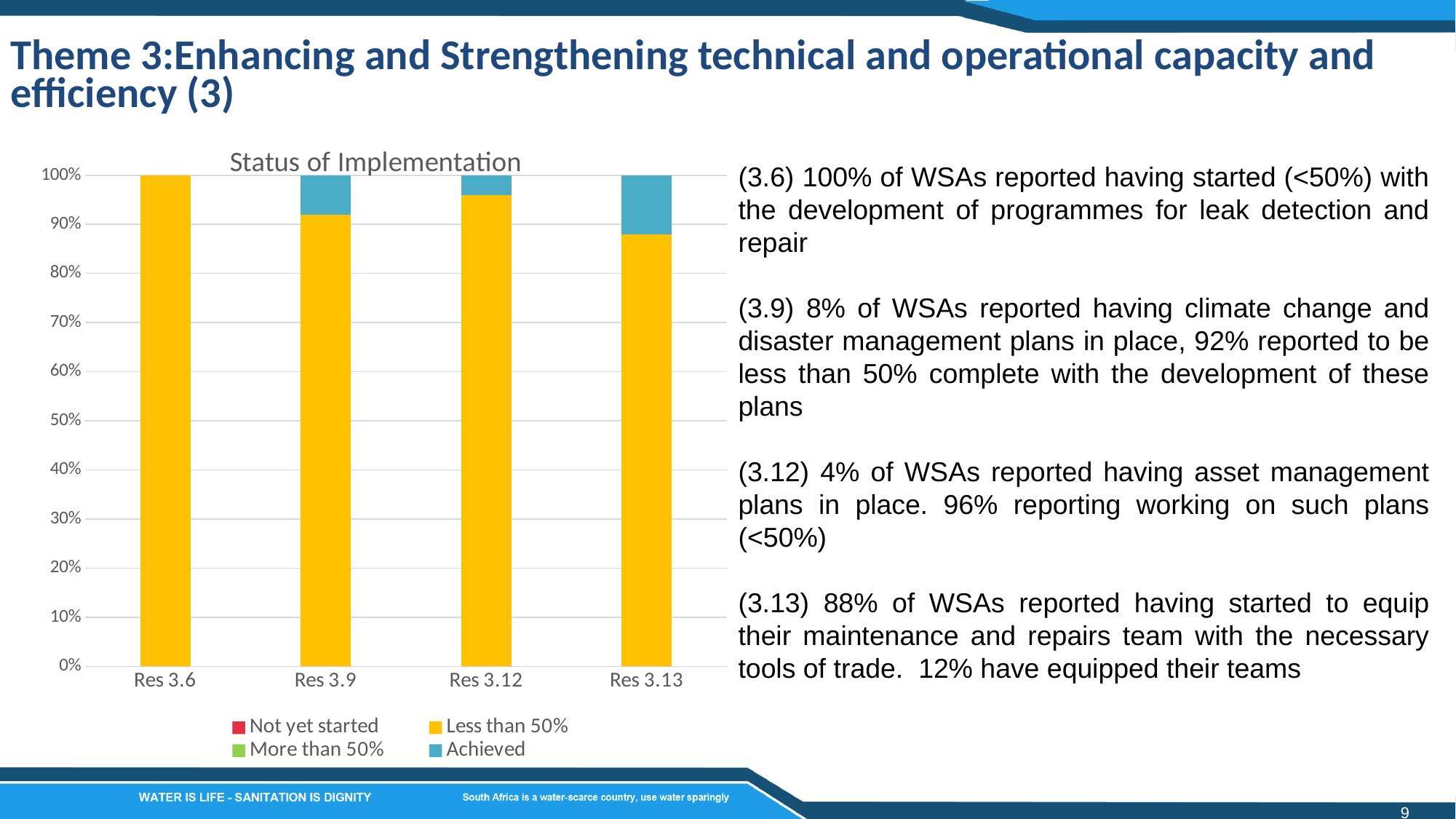
How many categories are shown on the x axis of the chart? 4 How many series does the chart legend list? 4 What kind of chart is shown under the title 'Status of Implementation'? Stacked bar chart What is the 'Less than 50%' value for Res 3.6? 100% Which category has the largest 'Achieved' segment? Res 3.13 What is the title of the chart? Status of Implementation Which is larger, the 'Achieved' segment for Res 3.9 or for Res 3.12? Res 3.9 Is the 'Less than 50%' value for Res 3.13 greater or less than 80%? greater Is the 'Achieved' value for Res 3.9 greater or less than 10%? less Which legend entry is shown in yellow? Less than 50% Which category has the smallest 'Less than 50%' segment? Res 3.13 Is the 'Less than 50%' value for Res 3.12 greater or less than 90%? greater